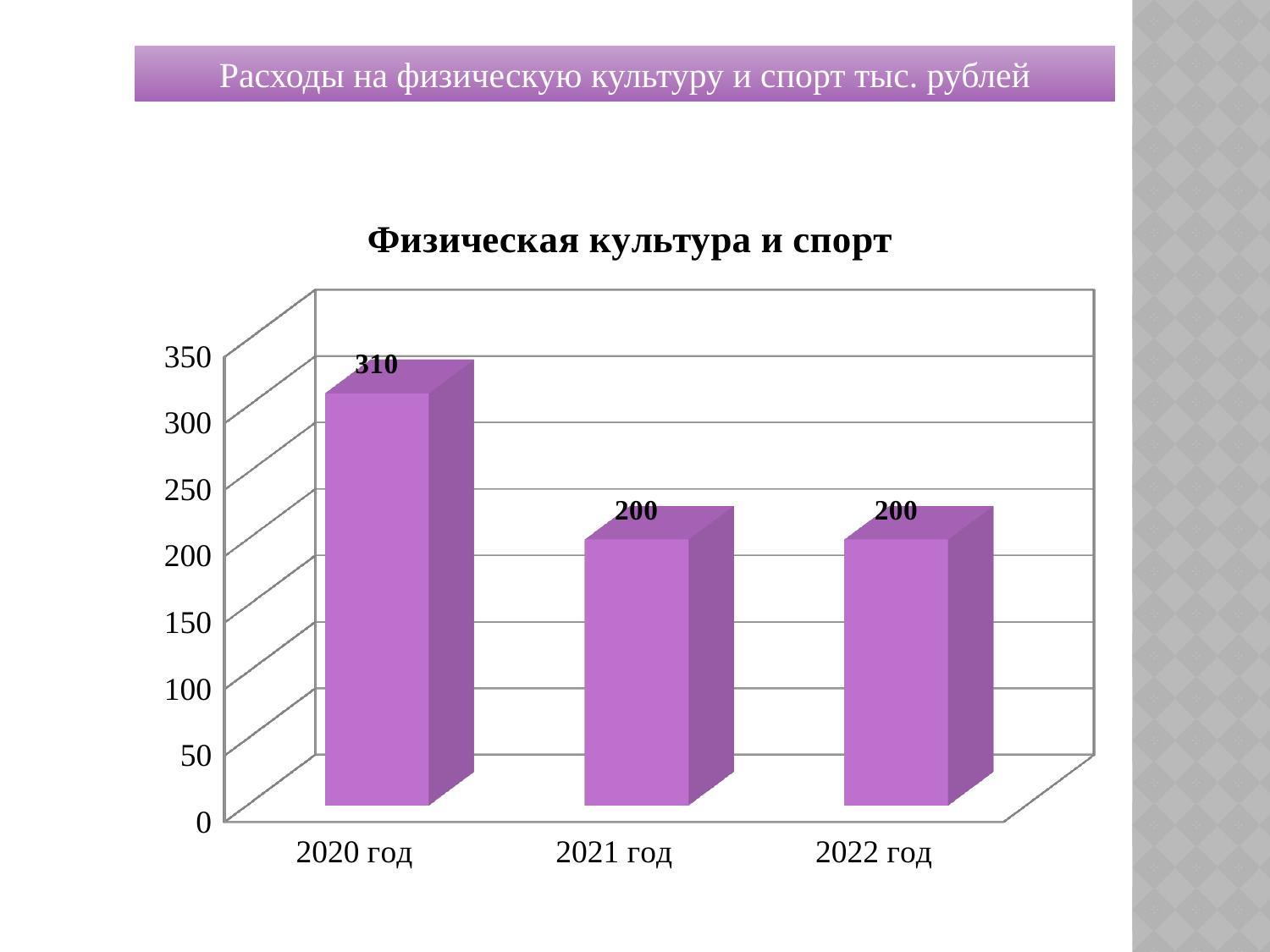
Is the value for 2021 год greater or less than 250? less What is the value for 2020 год? 310 Which year has the highest value? 2020 год What is the value for 2021 год? 200 Which is larger, the value for 2020 год or the value for 2022 год? 2020 год What is the value for 2022 год? 200 What is the difference between the values for 2020 год and 2021 год? 110 What is the title of the chart? Физическая культура и спорт How many categories are shown on the x axis? 3 Do the values rise or fall from 2020 год to 2021 год? fall Is the value for 2020 год greater or less than 300? greater What kind of chart is shown? bar chart